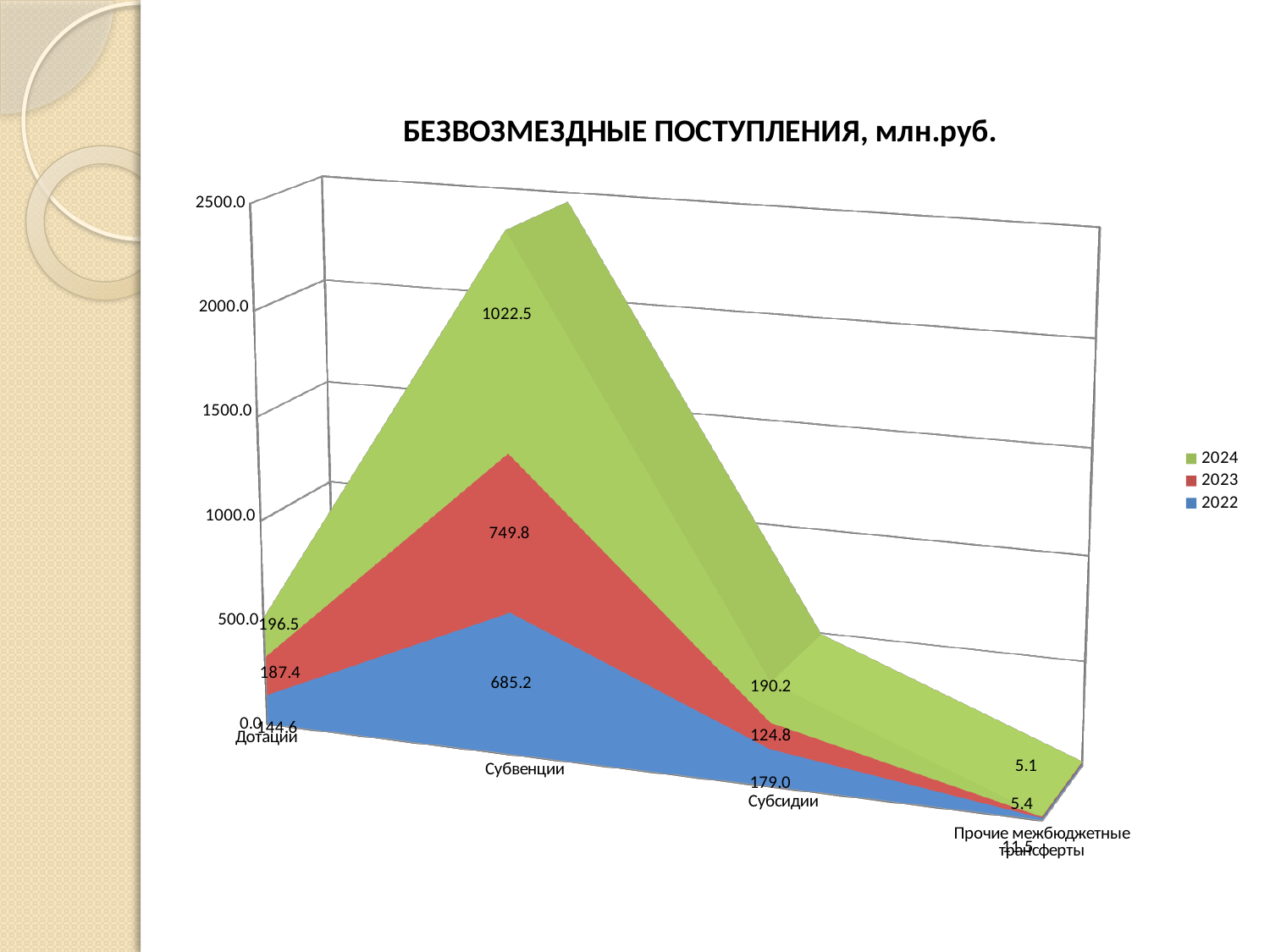
What is the difference between the 2024 and 2023 values for Субвенции? 272.7 Which category has the lowest value in the 2023 series? Прочие межбюджетные трансферты Which is larger for Субсидии: the 2022 value or the 2023 value? 2022 What is the value for Субвенции in the 2023 series? 749.8 What is the value for Субвенции in the 2022 series? 685.2 What is the value for Субвенции in the 2024 series? 1022.5 What is the title of the chart? БЕЗВОЗМЕЗДНЫЕ ПОСТУПЛЕНИЯ, млн.руб. What is the value for Дотации in the 2024 series? 196.5 Which category has the highest value in the 2024 series? Субвенции How many series does the legend list? 3 What is the value for Субсидии in the 2023 series? 124.8 How many categories are shown on the x axis? 4